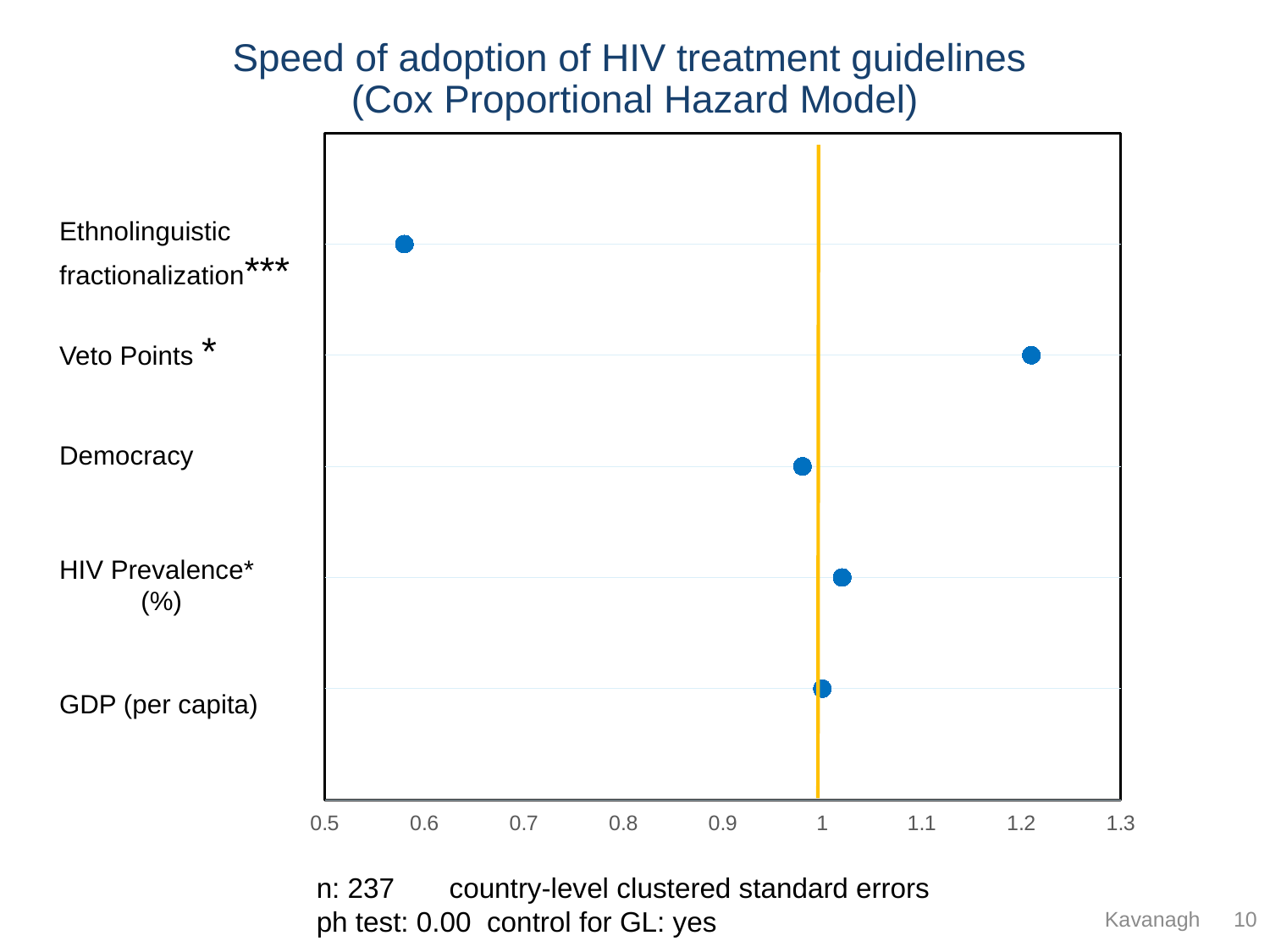
Is the value for Veto Points greater or less than 1.3? less Which is larger, the value for HIV Prevalence (%) or the value for Ethnolinguistic fractionalization? HIV Prevalence (%) Which is larger, the value for Veto Points or the value for Democracy? Veto Points Which variable has the lowest plotted value? Ethnolinguistic fractionalization At what x-axis value is the vertical reference line drawn? 1 Is the value for Veto Points greater or less than 1.1? greater Is the value for Ethnolinguistic fractionalization greater or less than 0.6? less What kind of chart is shown on the slide? Dot plot (scatter chart) What is the title of the chart? Speed of adoption of HIV treatment guidelines (Cox Proportional Hazard Model) Which variable has the highest plotted value? Veto Points How many variables (categories) are plotted on the chart? 5